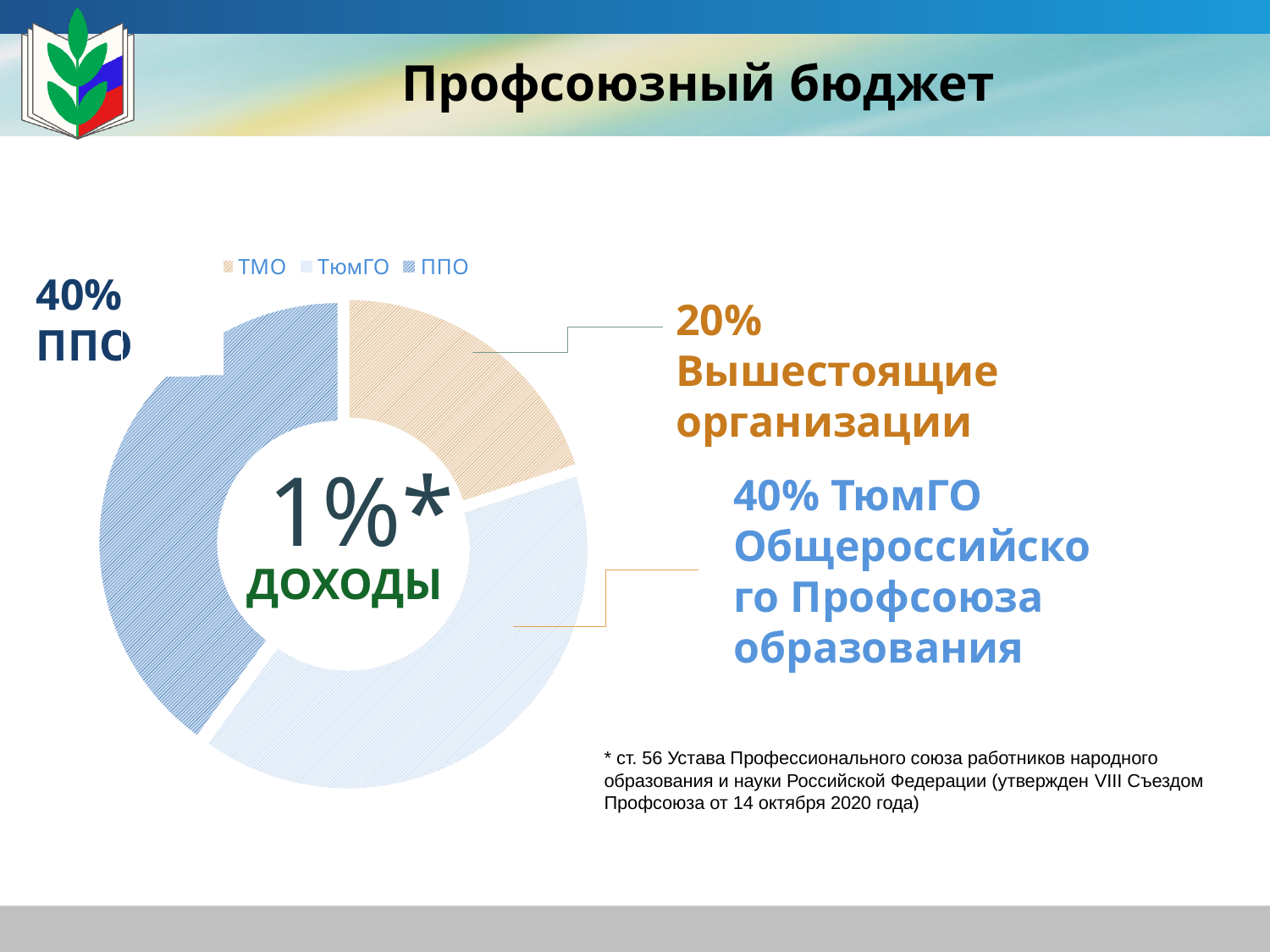
Which segment of the chart has the smallest share? Вышестоящие организации (ТМО), 20% Which is larger, the share for ППО or the share for Вышестоящие организации? ППО What percentage is shown for ППО? 40% What kind of chart is shown on the slide? Doughnut (pie) chart What is the combined share of ППО and ТюмГО? 80% What text is printed in the centre of the doughnut chart? 1%* доходы What percentage is shown for Вышестоящие организации? 20% What are the three entries in the chart legend? ТМО, ТюмГО, ППО How many entries does the chart legend list? 3 How many segments does the doughnut chart have? 3 What is the difference between the share for ТюмГО and the share for Вышестоящие организации? 20% What percentage is shown for ТюмГО? 40%